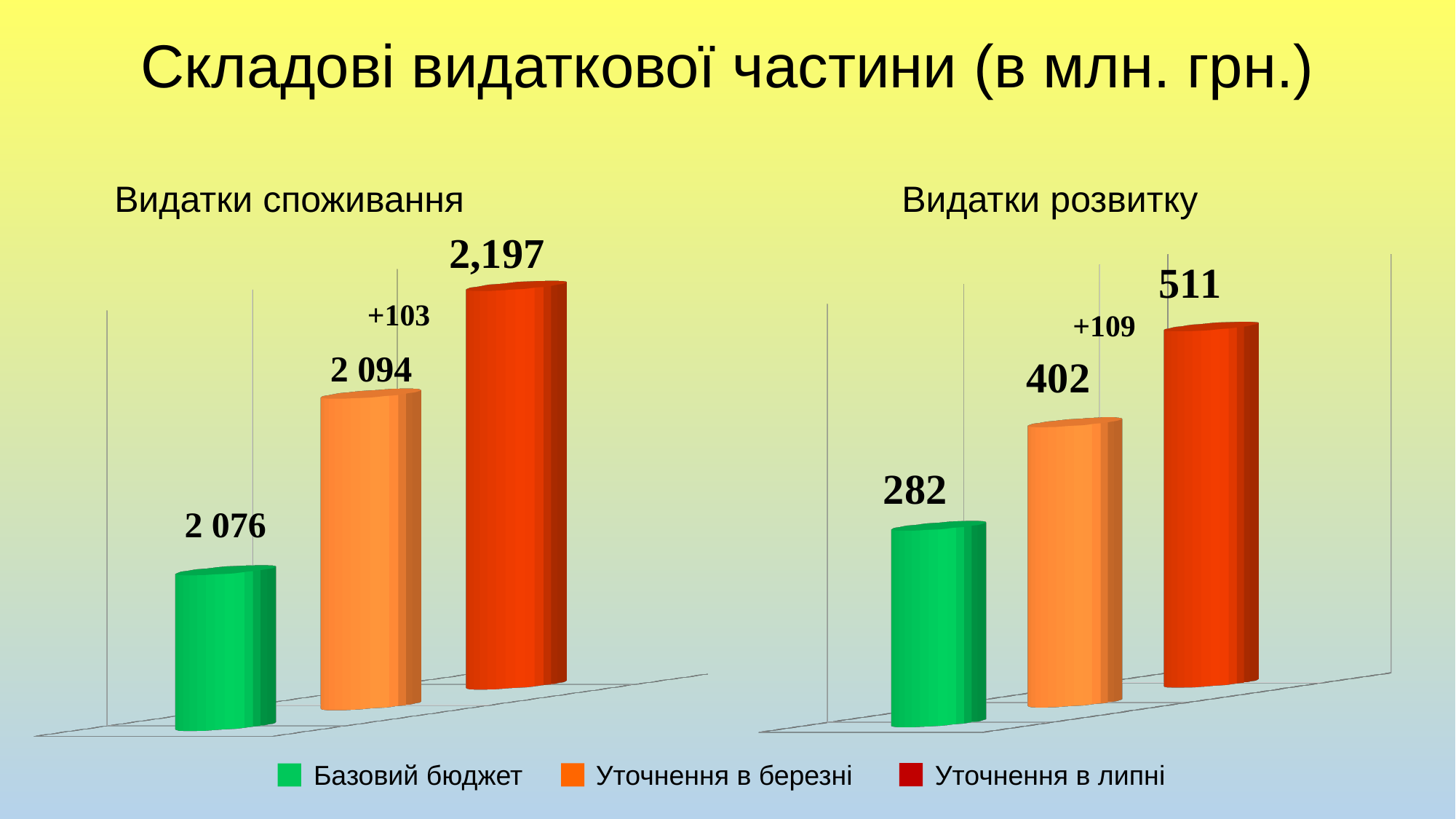
In the "Видатки розвитку" chart, which series has the highest value? Уточнення в липні In the "Видатки розвитку" chart, what is the difference between "Уточнення в липні" and "Базовий бюджет"? 229 In the "Видатки розвитку" chart, what is the value for "Базовий бюджет"? 282 In the "Видатки споживання" chart, what is the difference between "Уточнення в березні" and "Базовий бюджет"? 18 In the "Видатки споживання" chart, what is the value for "Уточнення в липні"? 2,197 What kind of chart is the "Видатки споживання" chart? Bar chart In the "Видатки споживання" chart, which series has the lowest value? Базовий бюджет In the "Видатки розвитку" chart, do the values rise or fall from left to right? Rise How many series does the legend list? 3 In the "Видатки розвитку" chart, what is the value for "Уточнення в березні"? 402 In the "Видатки споживання" chart, what is the value for "Базовий бюджет"? 2 076 In the "Видатки розвитку" chart, which is larger: "Уточнення в березні" or "Базовий бюджет"? Уточнення в березні